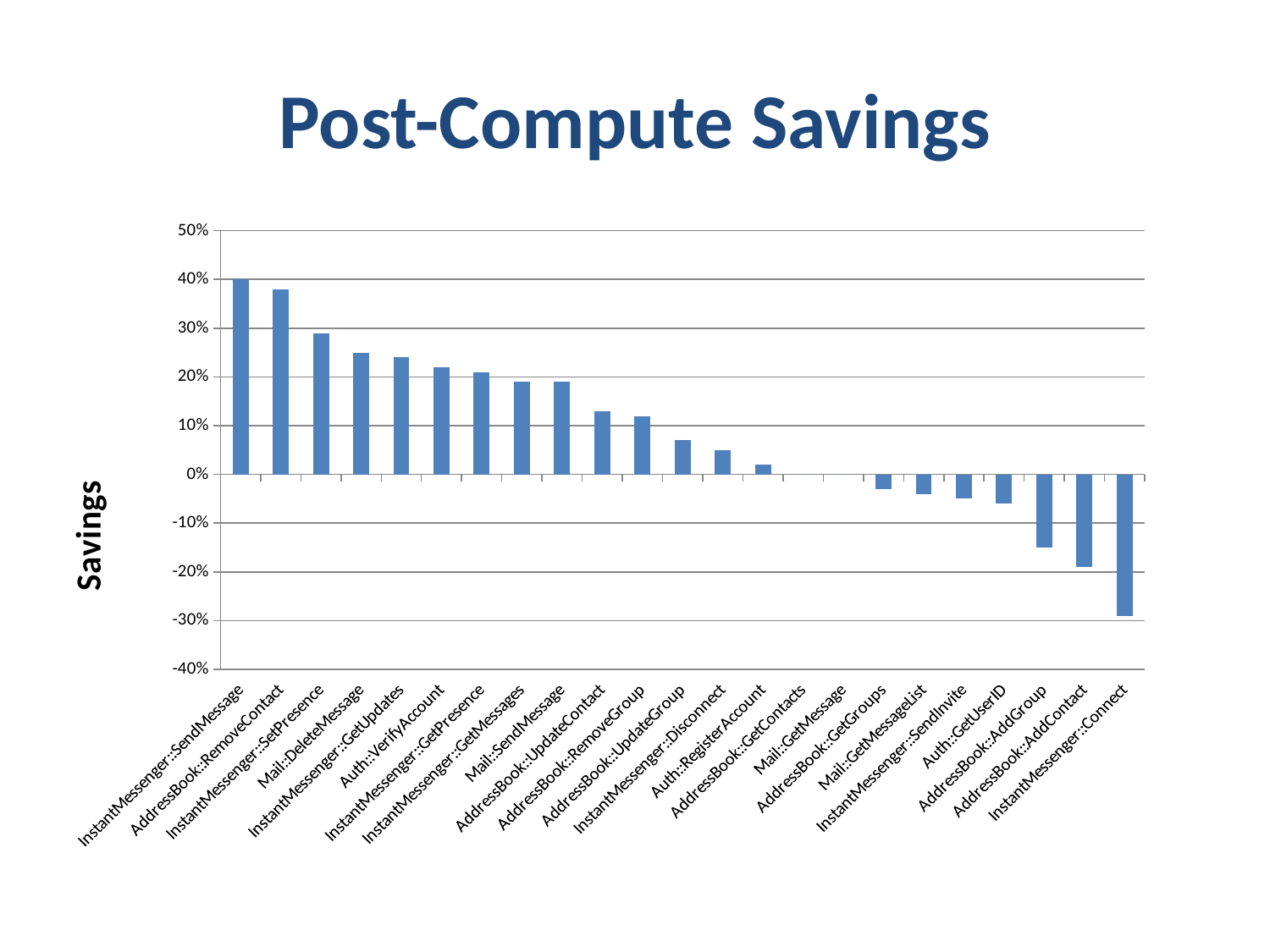
Do the values rise or fall moving from left to right along the x axis? fall Is the value for InstantMessenger::SendMessage greater or less than 30%? greater Which category has the highest savings value? InstantMessenger::SendMessage What is the label on the vertical axis? Savings Is the value for AddressBook::UpdateGroup greater or less than 10%? less Is the value for InstantMessenger::Connect greater or less than -20%? less Which is larger, the value for AddressBook::RemoveContact or the value for Mail::SendMessage? AddressBook::RemoveContact What kind of chart is shown on the slide? bar chart Which category has the lowest savings value? InstantMessenger::Connect How many categories are labelled on the x axis? 23